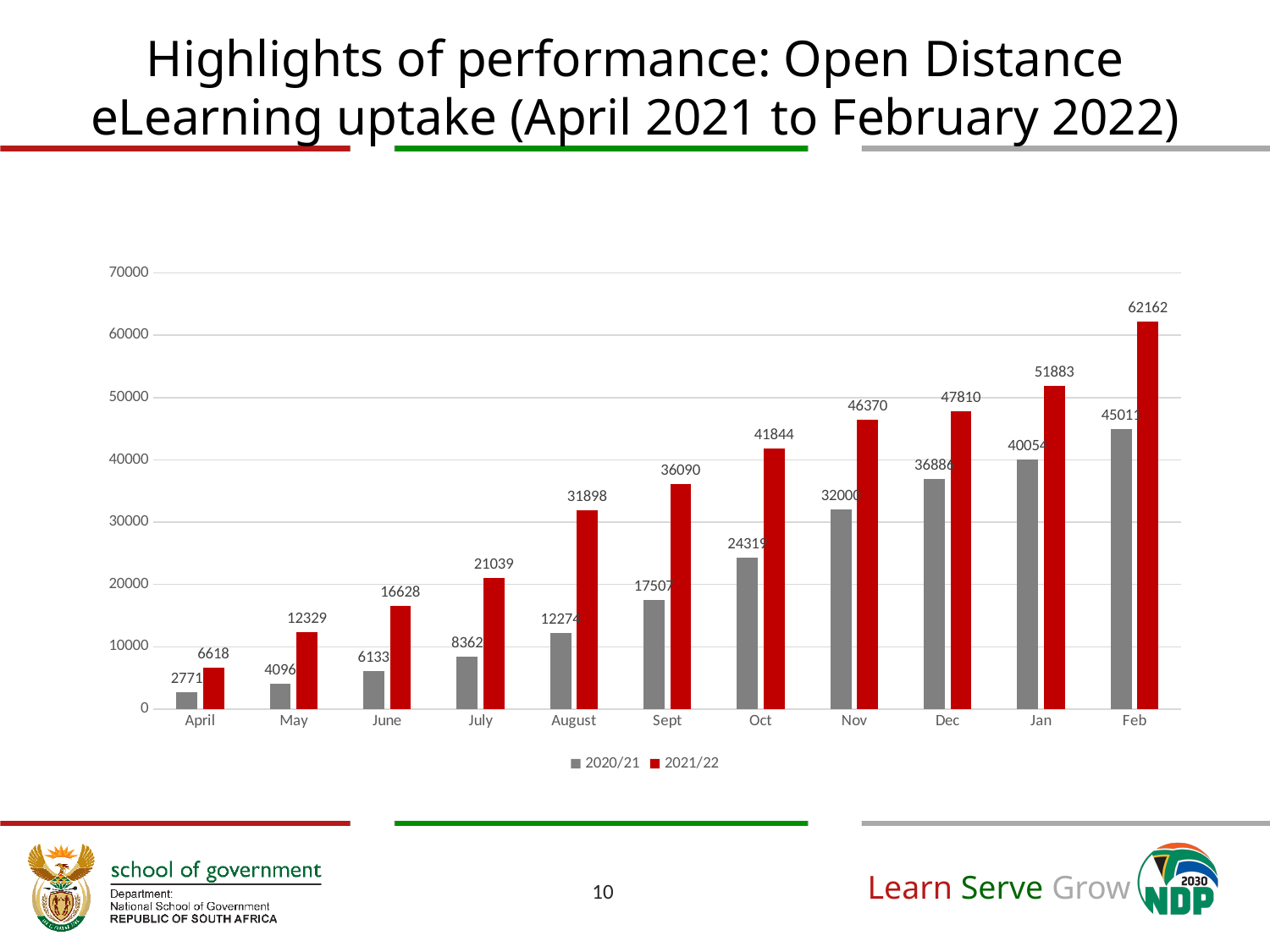
What is the value for Feb in the 2021/22 series? 62162 What is the value for August in the 2021/22 series? 31898 Which month has the lowest value in the 2021/22 series? April How many series does the legend list? 2 How many months are shown on the x axis? 11 Is the 2020/21 value for Oct greater or less than 20000? greater Which month has the highest value in the 2021/22 series? Feb Do the 2021/22 values rise or fall from April to Feb? rise Which is larger: the 2021/22 value for Nov or the 2021/22 value for Dec? Dec What kind of chart is shown on the slide? bar chart What is the value for May in the 2021/22 series? 12329 What is the difference between the 2021/22 values for Feb and Jan? 10279